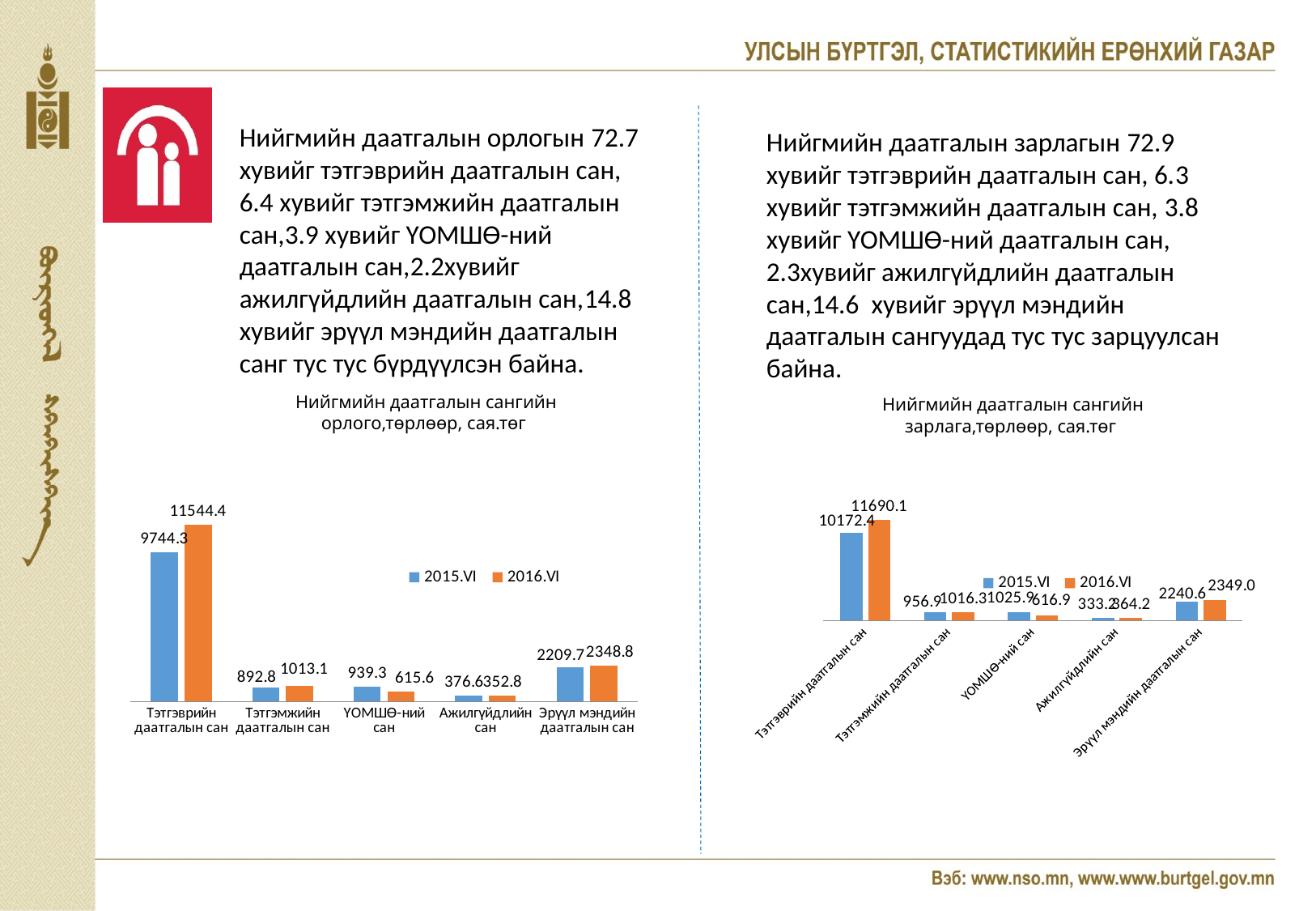
In the left chart (Нийгмийн даатгалын сангийн орлого), which category has the lowest 2016.VI value? Ажилгүйдлийн сан In the left chart (Нийгмийн даатгалын сангийн орлого), what is the 2015.VI value for ҮОМШӨ-ний сан? 939.3 In the right chart (Нийгмийн даатгалын сангийн зарлага), which category has the highest 2016.VI value? Тэтгэврийн даатгалын сан In the left chart (Нийгмийн даатгалын сангийн орлого), how many series does the legend list? 2 In the left chart (Нийгмийн даатгалын сангийн орлого), how many categories are shown on the x axis? 5 In the right chart (Нийгмийн даатгалын сангийн зарлага), what is the difference between the 2016.VI and 2015.VI values for Тэтгэврийн даатгалын сан? 1517.7 In the left chart (Нийгмийн даатгалын сангийн орлого), which is larger for ҮОМШӨ-ний сан: the 2015.VI value or the 2016.VI value? 2015.VI In the right chart (Нийгмийн даатгалын сангийн зарлага), what is the 2015.VI value for Тэтгэврийн даатгалын сан? 10172.4 What type of chart is the right chart (Нийгмийн даатгалын сангийн зарлага)? Bar chart In the right chart (Нийгмийн даатгалын сангийн зарлага), what is the 2016.VI value for Эрүүл мэндийн даатгалын сан? 2349.0 In the left chart (Нийгмийн даатгалын сангийн орлого), what is the difference between the 2016.VI and 2015.VI values for Эрүүл мэндийн даатгалын сан? 139.1 In the left chart (Нийгмийн даатгалын сангийн орлого), what is the 2016.VI value for Тэтгэврийн даатгалын сан? 11544.4